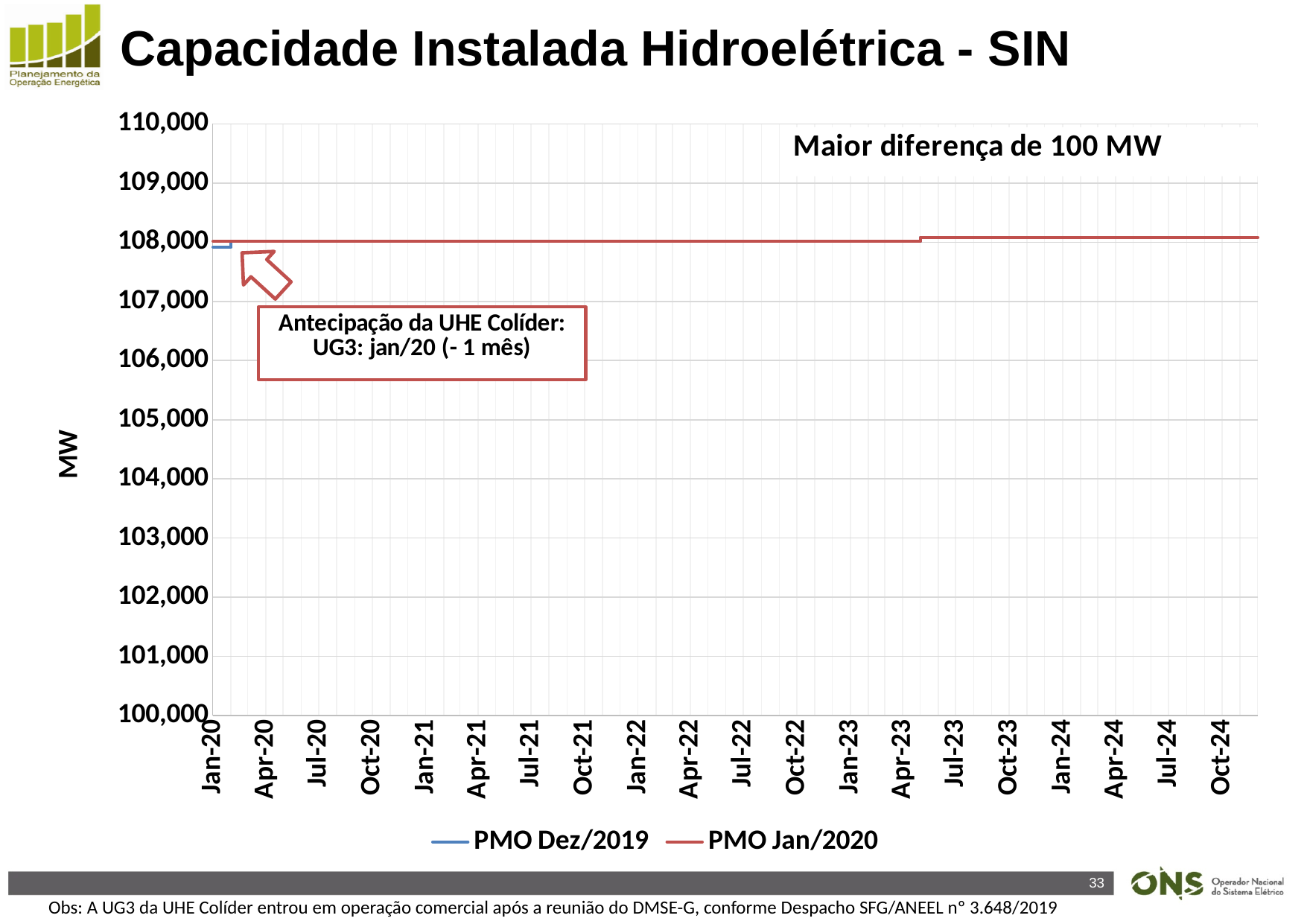
What kind of chart is shown on the slide? Line chart Does the PMO Jan/2020 line rise or fall between Jan-23 and Oct-24? rise Is the value of PMO Jan/2020 in Jan-22 greater or less than 107,000? greater What is the highest value shown on the y axis? 110,000 Is the value of PMO Jan/2020 in Oct-24 greater or less than 109,000? less How many date labels are shown on the x axis? 20 According to the annotation on the chart, what is the largest difference between the two series? 100 MW What is the last date label on the x axis? Oct-24 What is the first date label on the x axis? Jan-20 How many series does the legend list? 2 Is the value of PMO Jan/2020 in Jan-21 greater or less than 105,000? greater What are the two series named in the legend? PMO Dez/2019 and PMO Jan/2020